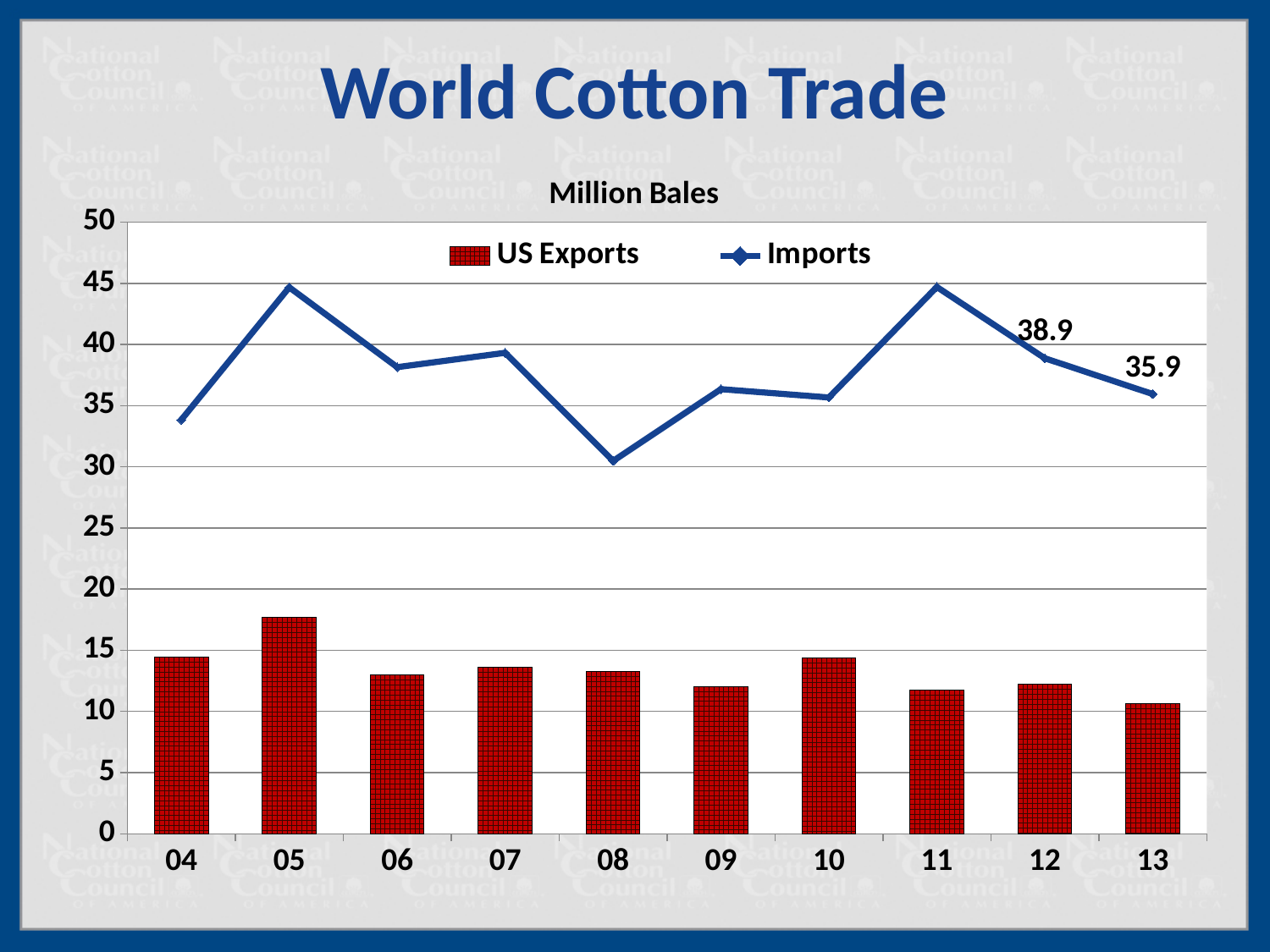
What is the difference between Imports in 12 and Imports in 13? 3.0 What is the value of Imports for 13? 35.9 Which is larger, Imports in 12 or Imports in 13? 12 How many series does the legend list? 2 Is the value for Imports in 11 greater or less than 40? greater What is the value of Imports for 12? 38.9 How many years are shown on the x axis? 10 Do Imports rise or fall from 11 to 13? fall Is the value for Imports in 08 greater or less than 35? less In which year are Imports lowest? 08 Is the value for US Exports in 05 greater or less than 15? greater In which year are US Exports highest? 05